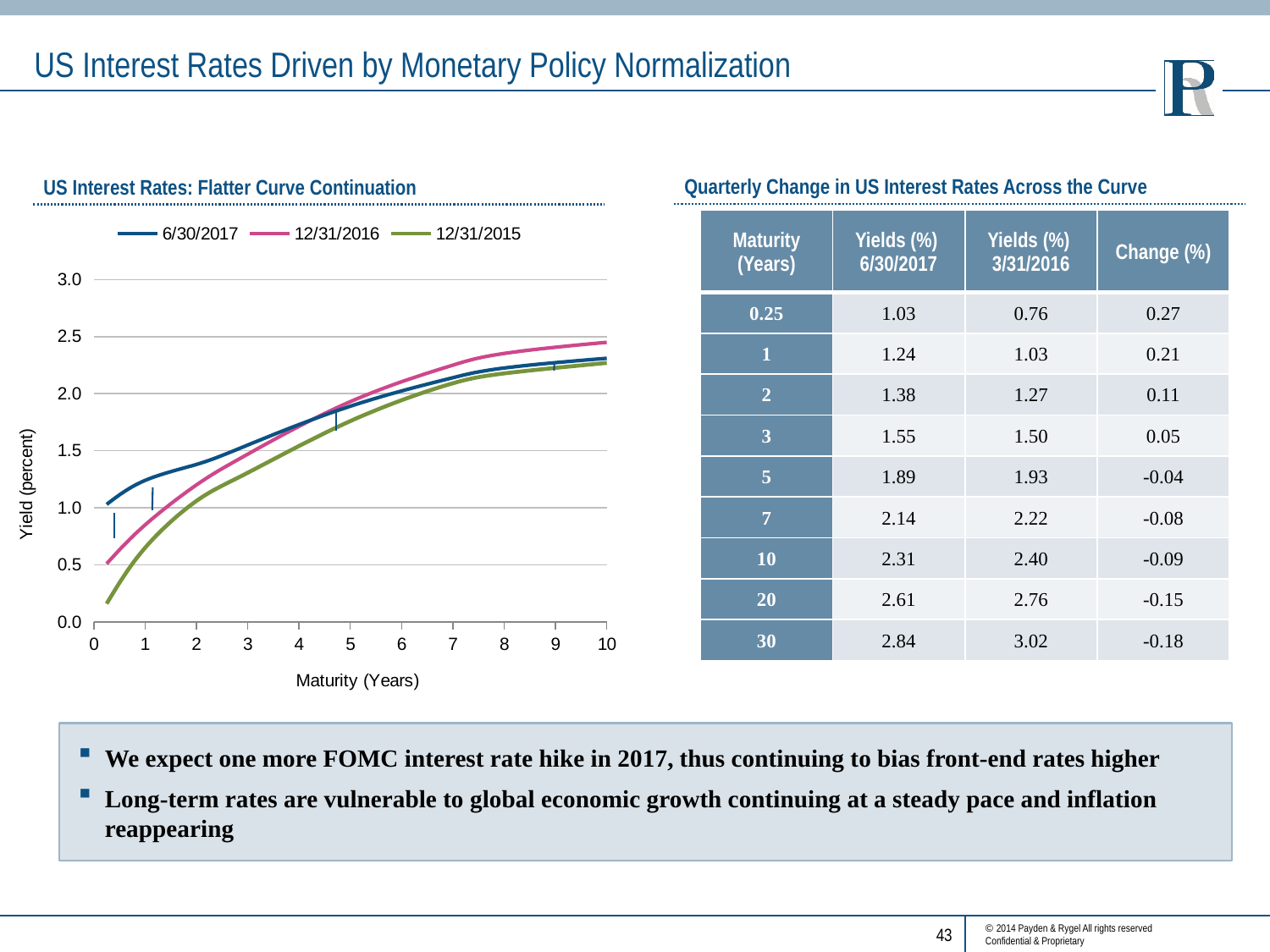
In the 'US Interest Rates: Flatter Curve Continuation' chart, is the 12/31/2015 yield at a maturity of 1 year greater or less than 1.0? less In the 'US Interest Rates: Flatter Curve Continuation' chart, is the 6/30/2017 yield at a maturity of 1 year greater or less than 1.0? greater In the 'US Interest Rates: Flatter Curve Continuation' chart, which series has the lowest yield at the shortest maturities? 12/31/2015 In the 'US Interest Rates: Flatter Curve Continuation' chart, do the yields rise or fall as maturity increases along the x axis? rise How many series does the legend of the 'US Interest Rates: Flatter Curve Continuation' chart list? 3 What is the label of the y axis in the 'US Interest Rates: Flatter Curve Continuation' chart? Yield (percent) In the 'US Interest Rates: Flatter Curve Continuation' chart, which series has the higher yield at a maturity of 10 years: 12/31/2016 or 6/30/2017? 12/31/2016 In the 'US Interest Rates: Flatter Curve Continuation' chart, is the 6/30/2017 yield at a maturity of 10 years greater or less than 2.0? greater What is the label of the x axis in the 'US Interest Rates: Flatter Curve Continuation' chart? Maturity (Years) What kind of chart is 'US Interest Rates: Flatter Curve Continuation'? line chart In the 'US Interest Rates: Flatter Curve Continuation' chart, which series has the higher yield at a maturity of 1 year: 6/30/2017 or 12/31/2015? 6/30/2017